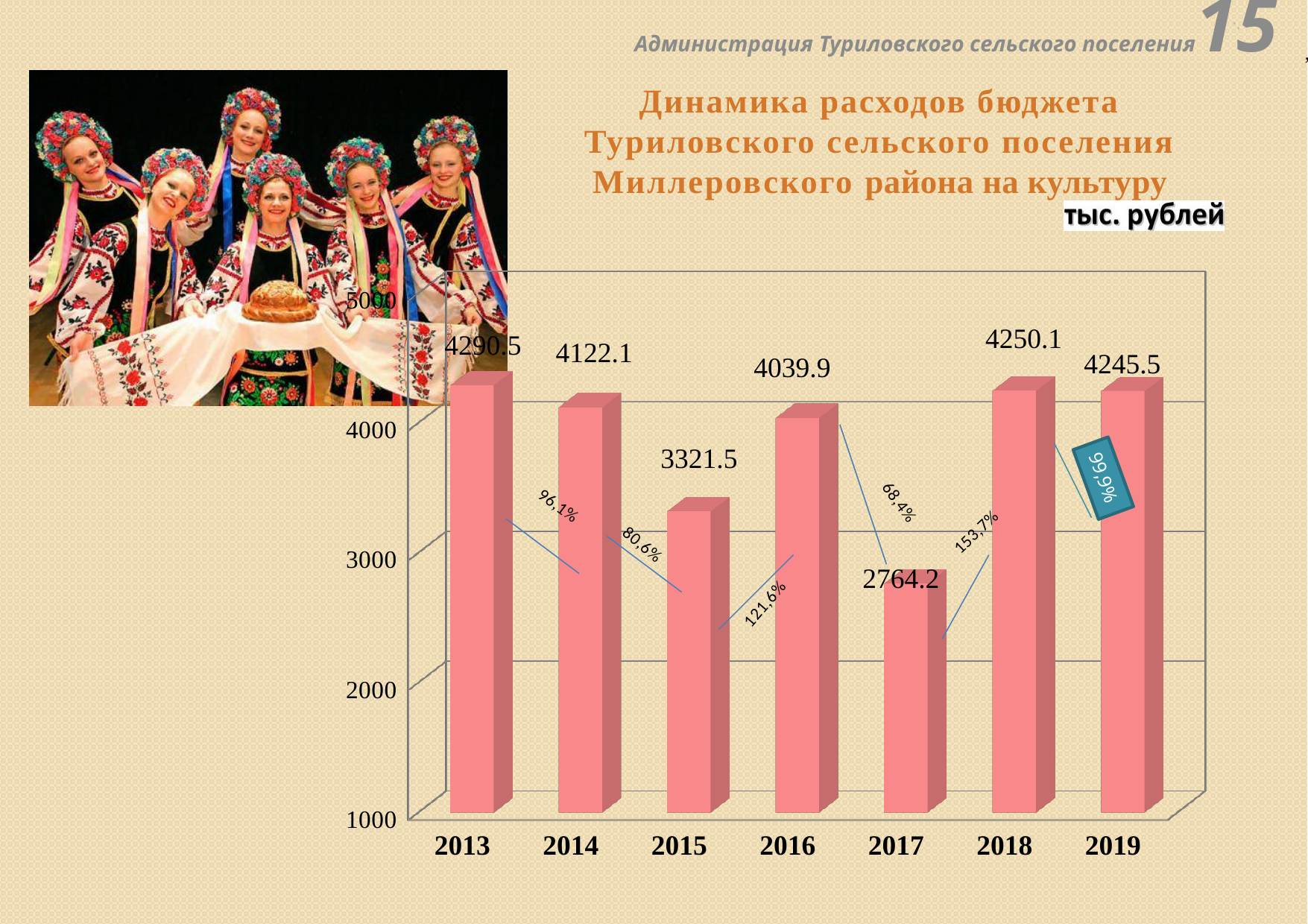
What is the value for 2017? 2764.2 Do the values rise or fall from 2017 to 2018? rise Which year has the lowest value? 2017 What unit is stated for the chart values? тыс. рублей What is the value for 2019? 4245.5 Which is larger, the value for 2014 or the value for 2015? 2014 What is the value for 2013? 4290.5 What kind of chart is shown on the slide? bar chart What is the difference between the values for 2016 and 2017? 1275.7 Which year has the highest value? 2013 Is the value for 2015 greater or less than 3000? greater How many years are shown on the x axis? 7